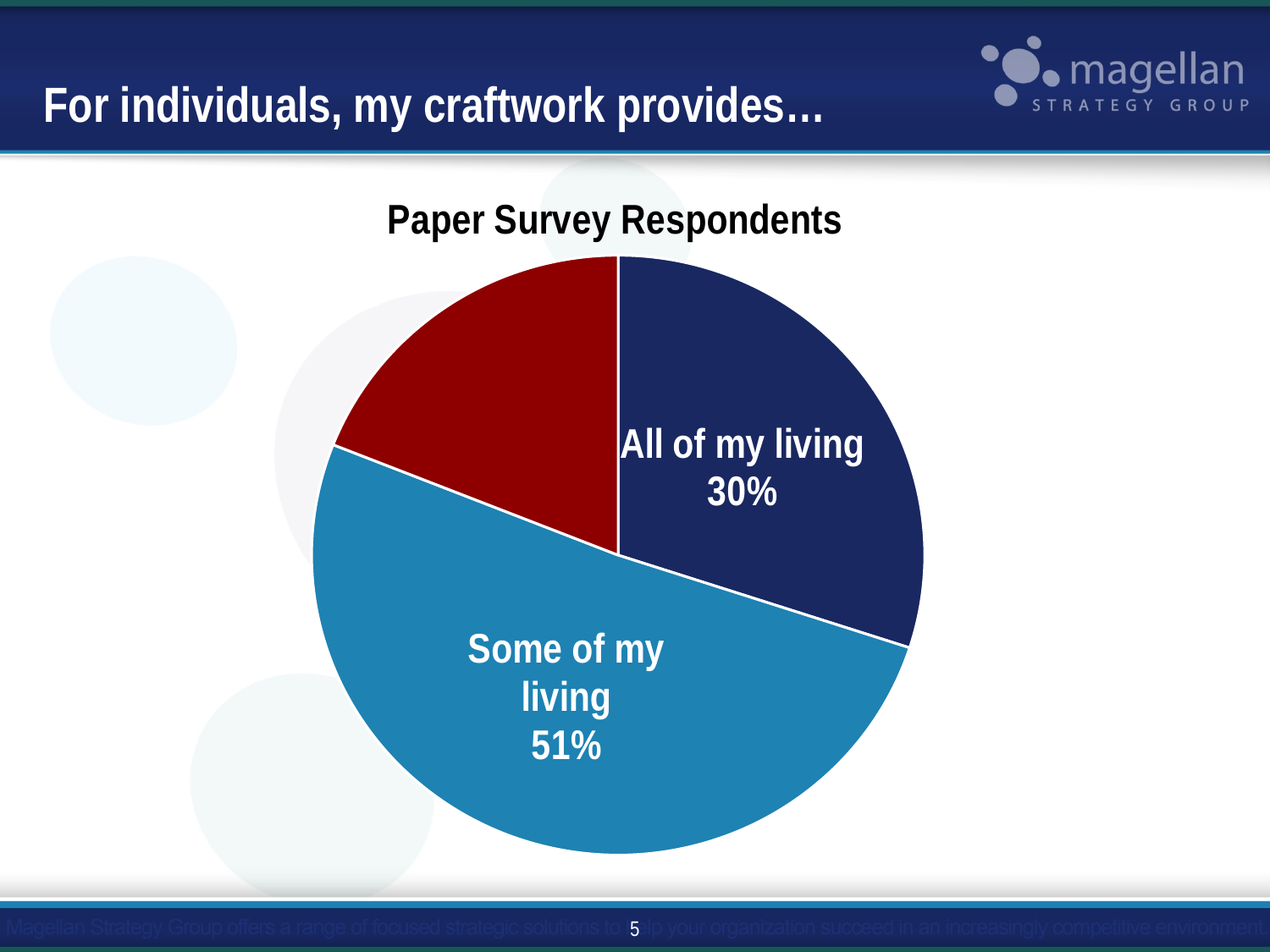
What is the title of the chart? Paper Survey Respondents What kind of chart is shown on the slide? pie chart By how many percentage points does 'Some of my living' exceed 'All of my living'? 21 percentage points What percentage of paper survey respondents said their craftwork provides some of their living? 51% What percentage of paper survey respondents said their craftwork provides all of their living? 30% Which labelled slice of the pie is the largest? Some of my living What colour is the 'All of my living' slice? dark blue What share of the pie does the 'Some of my living' slice represent? 51% Which is larger: the share for 'Some of my living' or the share for 'All of my living'? Some of my living How many slices does the pie chart have? 3